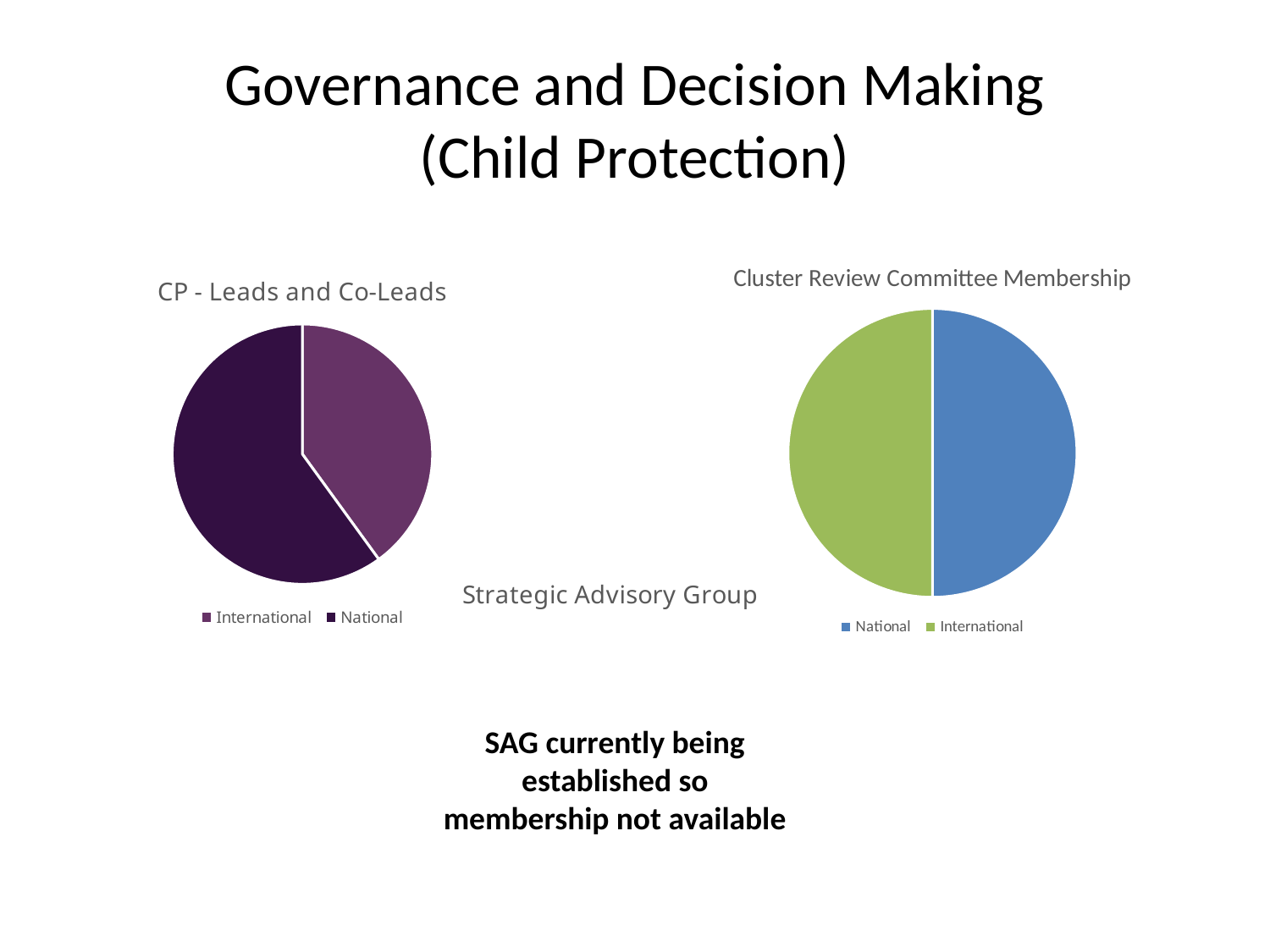
How many slices does the "Cluster Review Committee Membership" pie chart have? 2 In the "Cluster Review Committee Membership" chart, which colour represents National? blue In the "CP - Leads and Co-Leads" chart, which is larger, International or National? National What kind of chart is the "Cluster Review Committee Membership" chart? pie chart How many entries does the legend of the "Cluster Review Committee Membership" chart list? 2 In the "CP - Leads and Co-Leads" chart, which category has the largest slice? National How many entries does the legend of the "CP - Leads and Co-Leads" chart list? 2 How many slices does the "CP - Leads and Co-Leads" pie chart have? 2 What kind of chart is the "CP - Leads and Co-Leads" chart? pie chart In the "CP - Leads and Co-Leads" chart, which category has the smallest slice? International What is the title of the pie chart on the right of the slide? Cluster Review Committee Membership